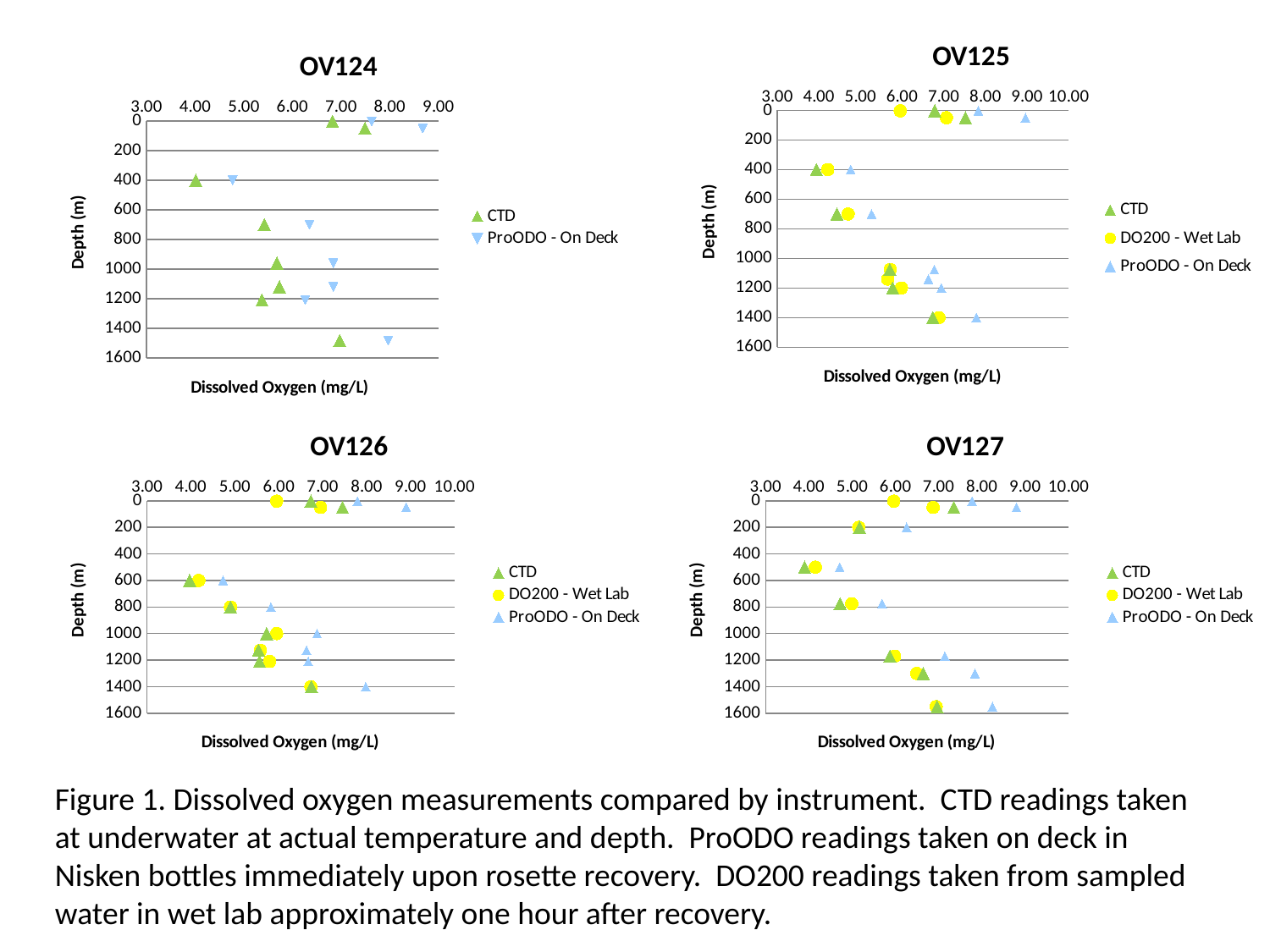
In the OV124 chart, is the ProODO - On Deck value at about 1500 m depth greater or less than 7.00? greater In the OV126 chart, is the CTD value at 600 m depth greater or less than 5.00? less In the OV127 chart, at about 1550 m depth, which series has the larger value: CTD or ProODO - On Deck? ProODO - On Deck How many series does the legend of the OV124 chart list? 2 How many charts are shown on the slide? 4 How many series does the legend of the OV125 chart list? 3 In the OV126 chart, which series is shown with yellow circle markers? DO200 - Wet Lab What is the x-axis label of the OV127 chart? Dissolved Oxygen (mg/L) In the OV125 chart, is the CTD value at 400 m depth greater or less than 5.00? less What kind of chart is OV124? Scatter chart In the OV125 chart, at 400 m depth, which series has the larger value: CTD or ProODO - On Deck? ProODO - On Deck